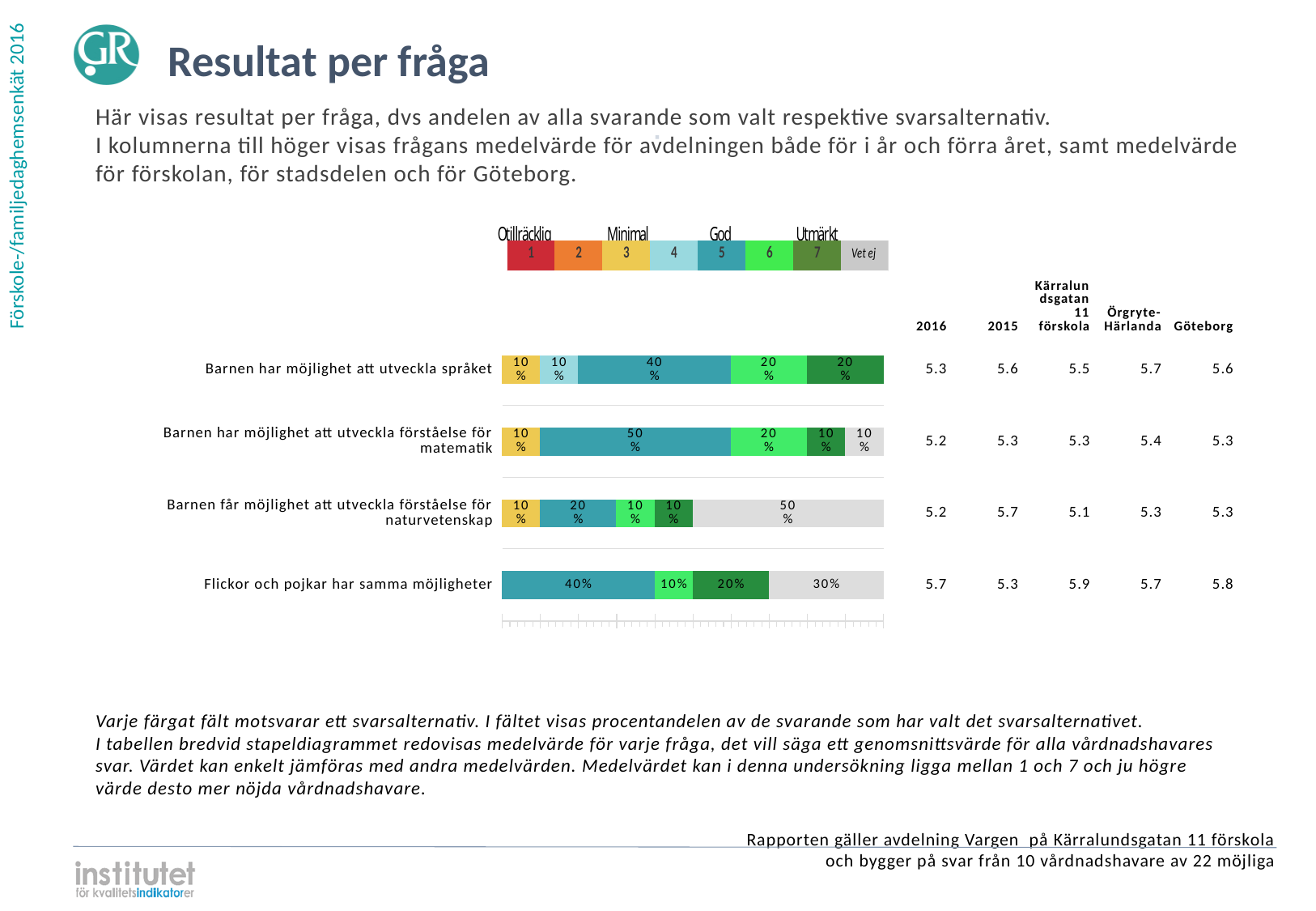
What percentage of respondents chose option 5 for 'Barnen har möjlighet att utveckla förståelse för matematik'? 50% Which is larger: the option 7 share for 'Barnen har möjlighet att utveckla språket' or for 'Barnen har möjlighet att utveckla förståelse för matematik'? Barnen har möjlighet att utveckla språket What percentage of respondents chose option 7 (Utmärkt) for 'Flickor och pojkar har samma möjligheter'? 20% Which question has the largest 'Vet ej' share? Barnen får möjlighet att utveckla förståelse för naturvetenskap How many response options does the legend above the chart list, including 'Vet ej'? 8 What kind of chart is shown on the slide? Stacked bar chart What is the 2016 mean value shown for 'Flickor och pojkar har samma möjligheter'? 5.7 How many questions (categories) are plotted in the bar chart? 4 What percentage of respondents chose option 5 (God) for 'Barnen har möjlighet att utveckla språket'? 40% What is the total of all segments in the bar for 'Flickor och pojkar har samma möjligheter'? 100% What share of respondents answered 'Vet ej' for 'Barnen får möjlighet att utveckla förståelse för naturvetenskap'? 50% What is the difference between the option 5 share for 'Barnen har möjlighet att utveckla förståelse för matematik' and for 'Barnen får möjlighet att utveckla förståelse för naturvetenskap'? 30 percentage points